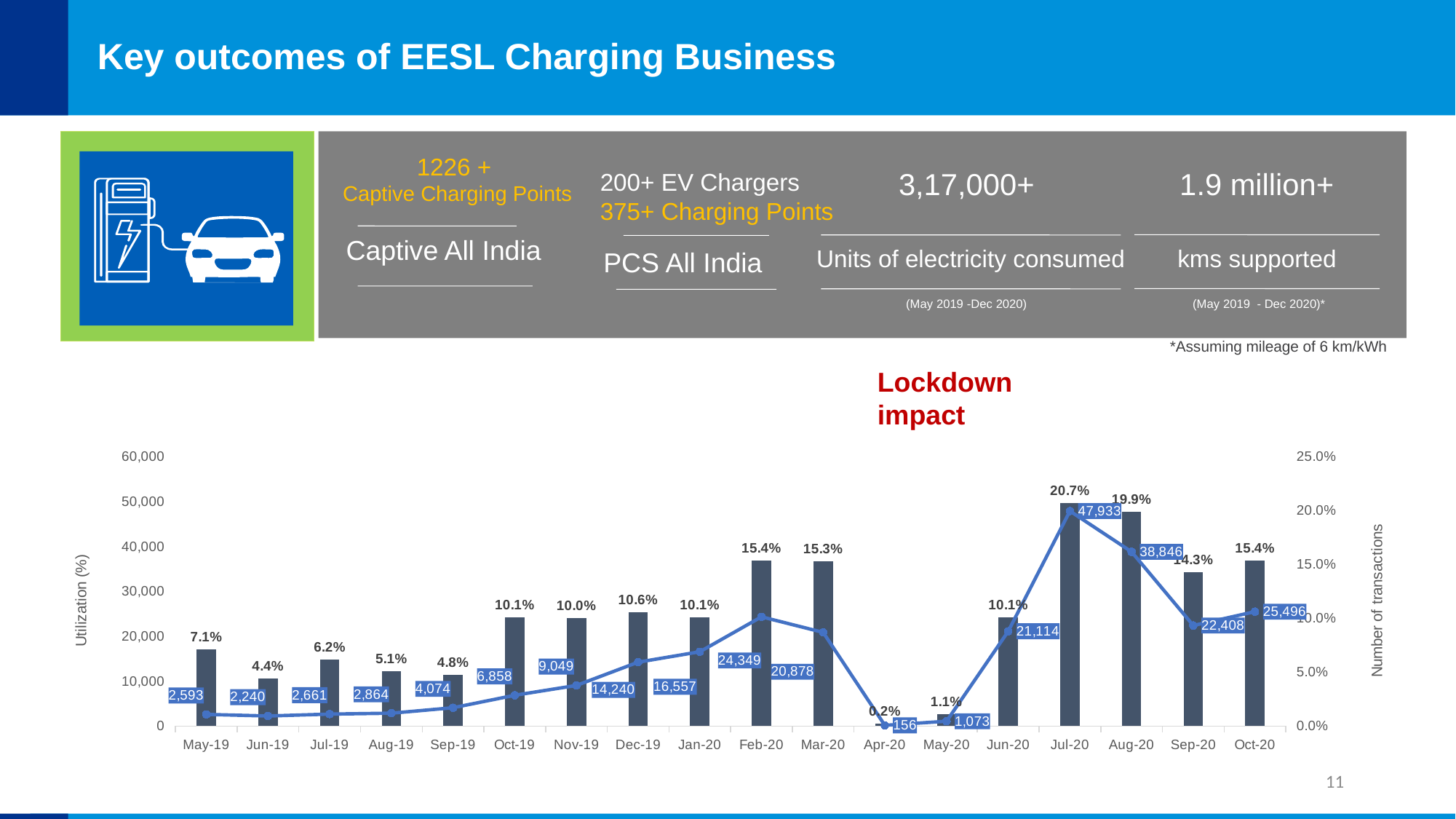
Which month has the lowest number of transactions? Apr-20 Which month has more transactions, Sep-20 or Oct-20? Oct-20 Do the number of transactions rise or fall from May-19 to Feb-20? Rise What is the difference in number of transactions between Jul-20 and Aug-20? 9,087 What label is written in red above the chart? Lockdown impact What is the utilization percentage shown for Jul-20? 20.7% What kind of chart is shown on the slide? Combined bar and line chart What is the utilization percentage shown for Sep-19? 4.8% What is the number of transactions shown for Apr-20? 156 What is the number of transactions shown for Feb-20? 24,349 How many months are shown on the x axis of the chart? 18 Which month has the highest utilization percentage? Jul-20